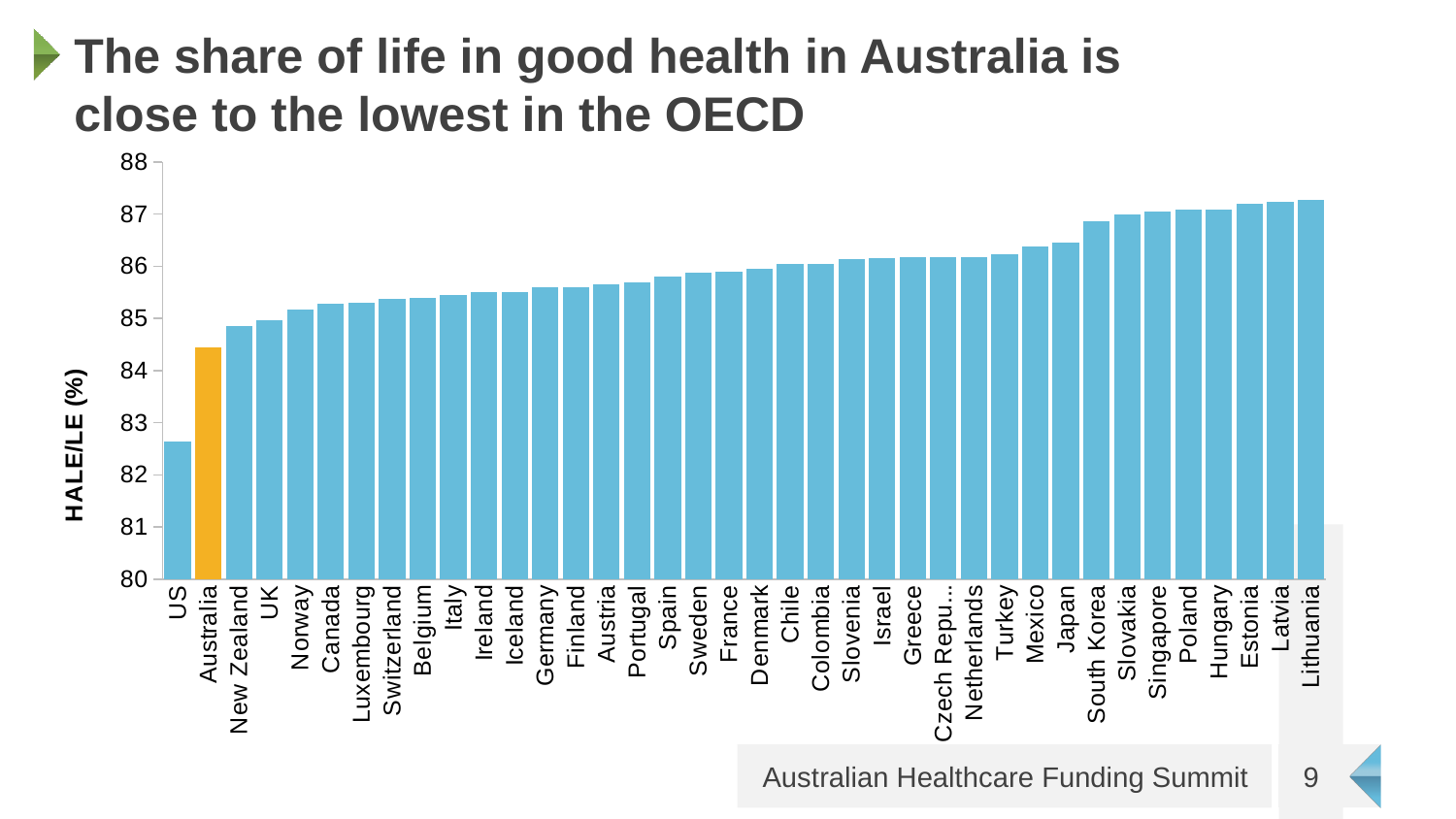
What kind of chart is shown on the slide? bar chart Which has a higher HALE/LE (%) value, Canada or Estonia? Estonia Do the values rise or fall moving from left to right along the x axis? rise Is the value for the US greater or less than 83? less Is the value for Australia greater or less than 84? greater How many countries are shown on the x axis? 38 Which country has the lowest HALE/LE (%) value? US Which has a higher HALE/LE (%) value, Australia or Japan? Japan Is the value for Lithuania greater or less than 87? greater Which country's bar is highlighted in orange? Australia